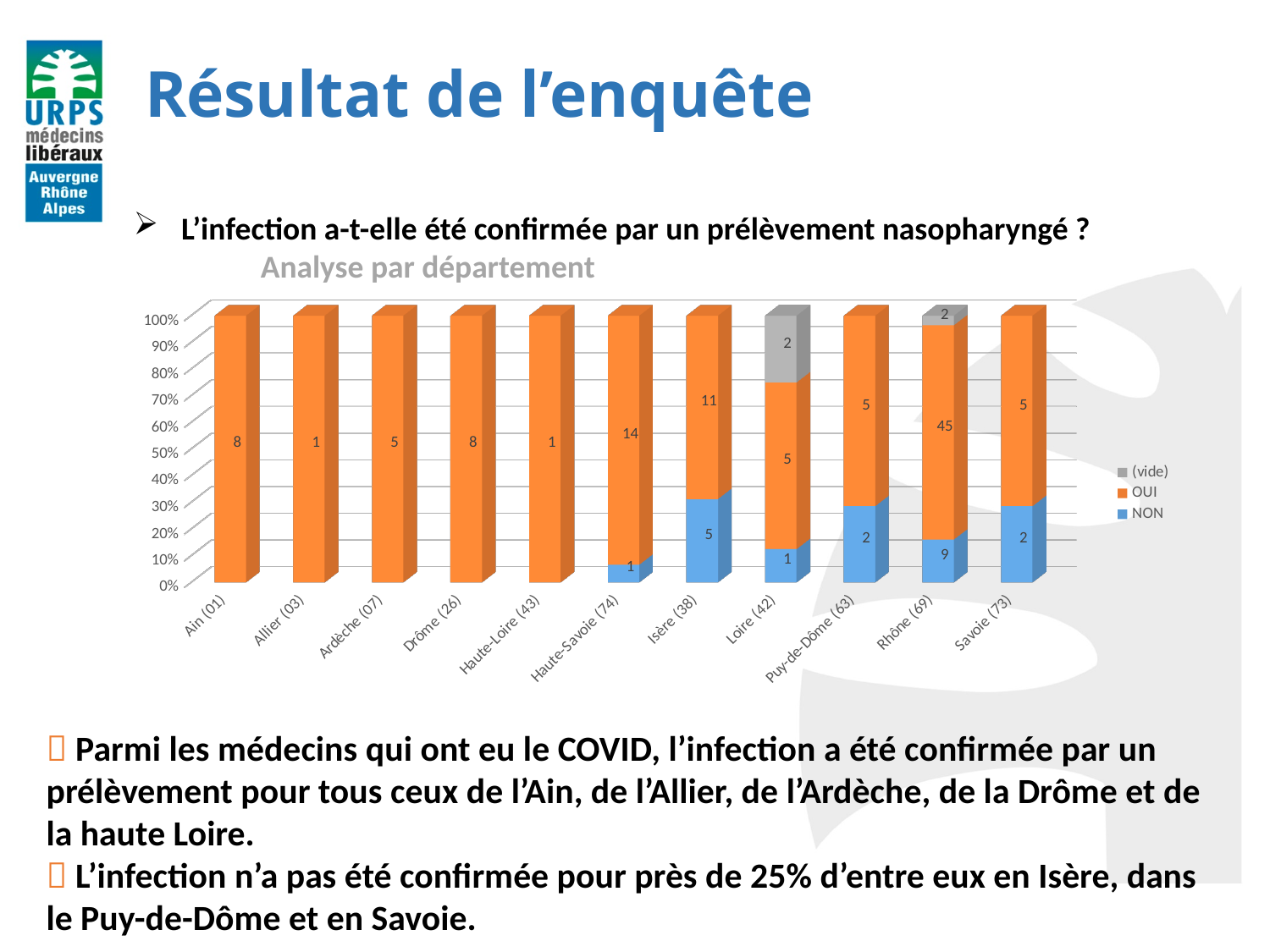
Which is larger, the OUI value for Isère (38) or the OUI value for Ain (01)? Isère (38) What is the NON value for Isère (38)? 5 What is the total of the stacked bar for Rhône (69)? 56 What is the OUI value for Rhône (69)? 45 What is the difference between the OUI and NON values for Rhône (69)? 36 Which département has the highest OUI value? Rhône (69) What is the title of the chart? Analyse par département How many départements are shown on the x axis? 11 What is the total of the stacked bar for Isère (38)? 16 How many series does the legend list? 3 What is the (vide) value for Loire (42)? 2 What is the OUI value for Haute-Savoie (74)? 14